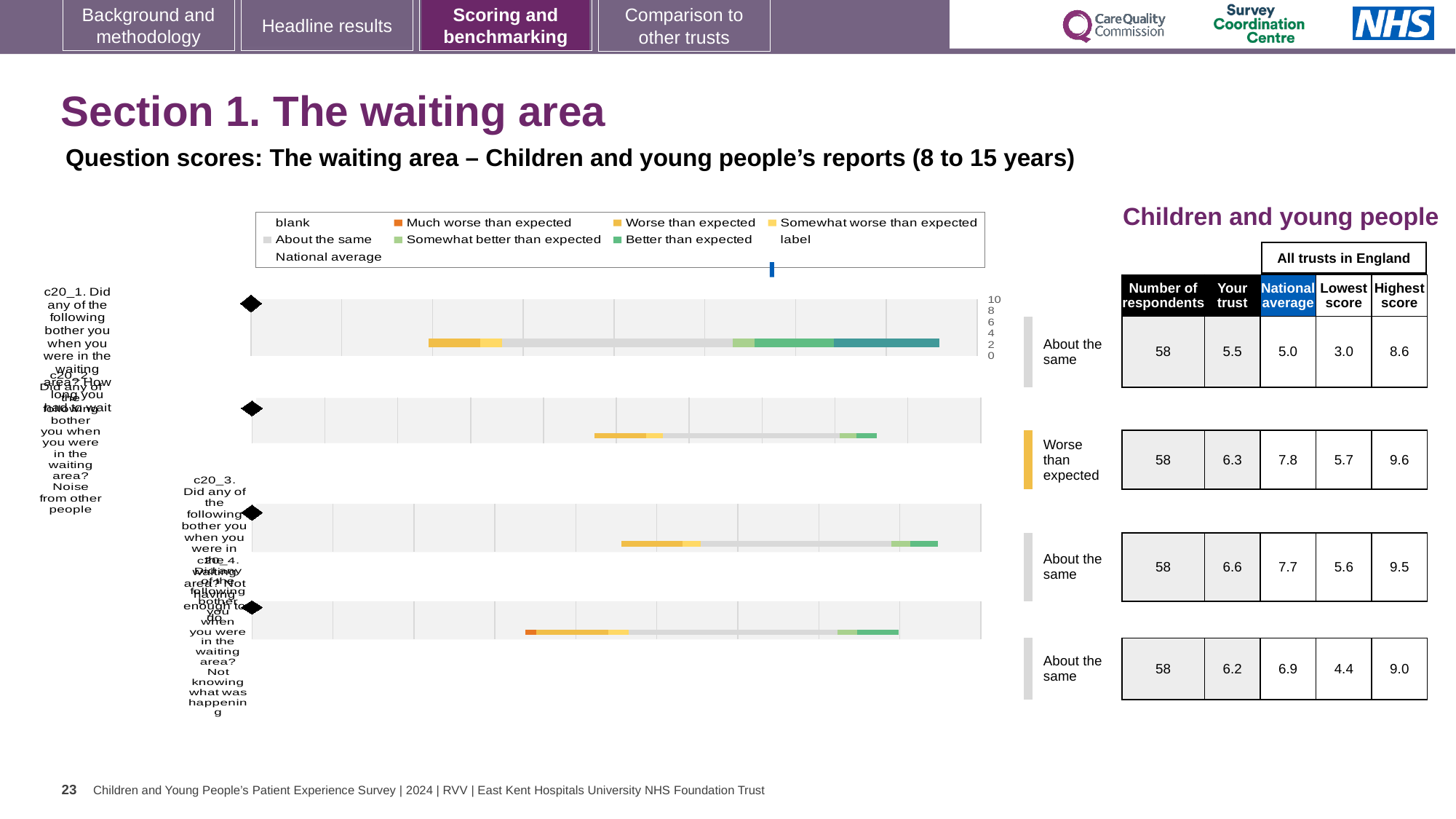
In the table, what is the 'Your trust' score for the first question (c20_1)? 5.5 What colour does the legend use for 'Much worse than expected'? orange In the table, what is the number of respondents for the first question row? 58 How many question bars are plotted in the chart? 4 Which question row is rated 'Worse than expected' rather than 'About the same'? the second row In the second question row, what is the difference between the national average and the 'Your trust' score? 1.5 Which question row has the highest 'Highest score' value in the table? the second row (9.6) What kind of chart is shown on the slide? bar chart In the table, what is the national average for the second question row? 7.8 In the first question row, which is larger: the 'Your trust' score or the national average? Your trust How many entries does the chart legend list? 9 What is the heading above the 'National average', 'Lowest score' and 'Highest score' columns in the table? All trusts in England